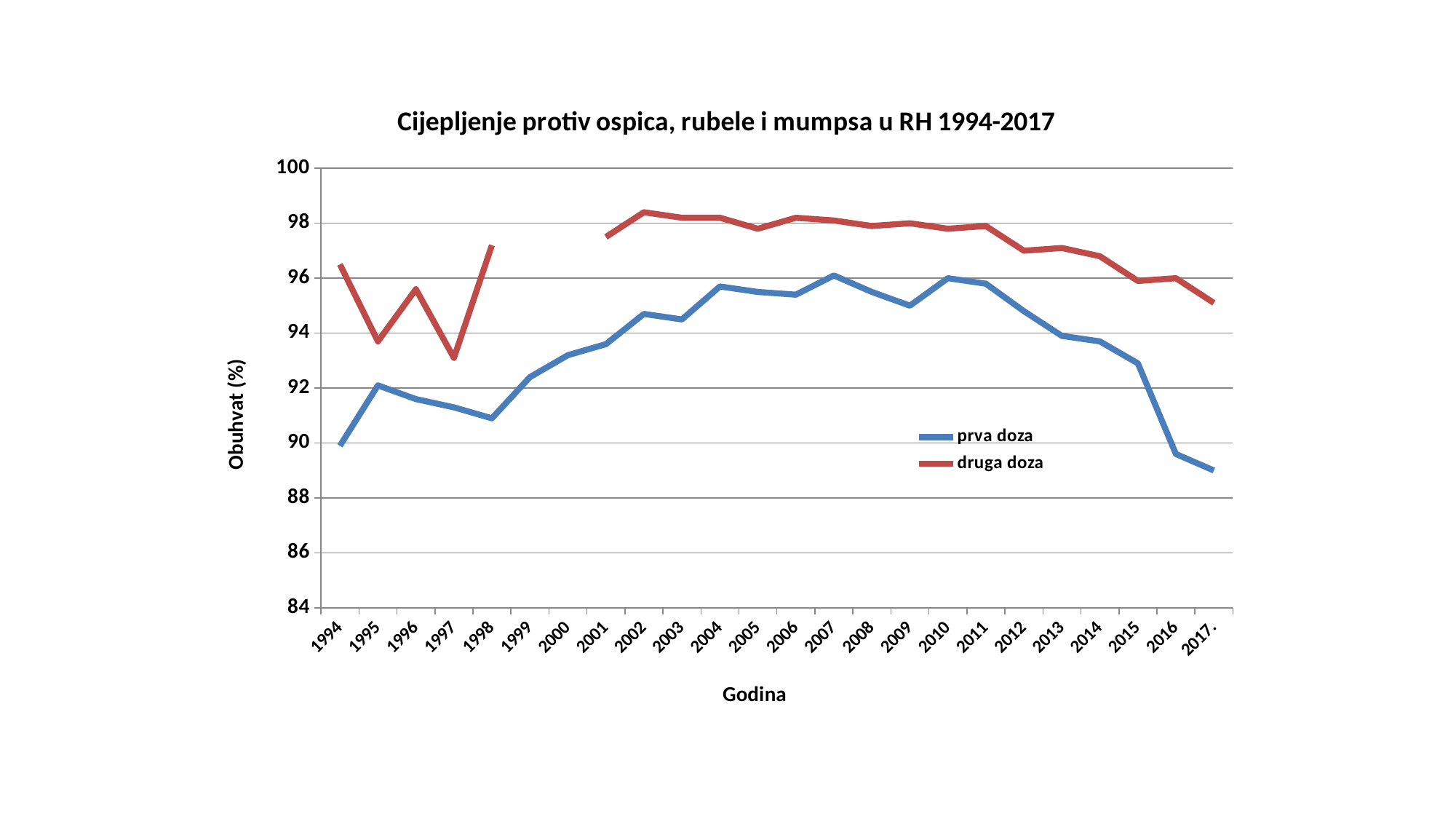
Which year has the lowest value for 'prva doza'? 2017 Is the value for 'druga doza' in 1997 greater or less than 94? less Do the values for 'prva doza' rise or fall from 2011 to 2017? fall Is the value for 'prva doza' in 2016 greater or less than 90? less Which colour is used for the 'druga doza' series? red Is the value for 'prva doza' in 2004 greater or less than 94? greater What is the title of the chart? Cijepljenje protiv ospica, rubele i mumpsa u RH 1994-2017 What kind of chart is shown on the slide? line chart How many years are shown on the x axis? 24 How many series does the legend list? 2 Which is larger in 2012, the value for 'prva doza' or the value for 'druga doza'? druga doza